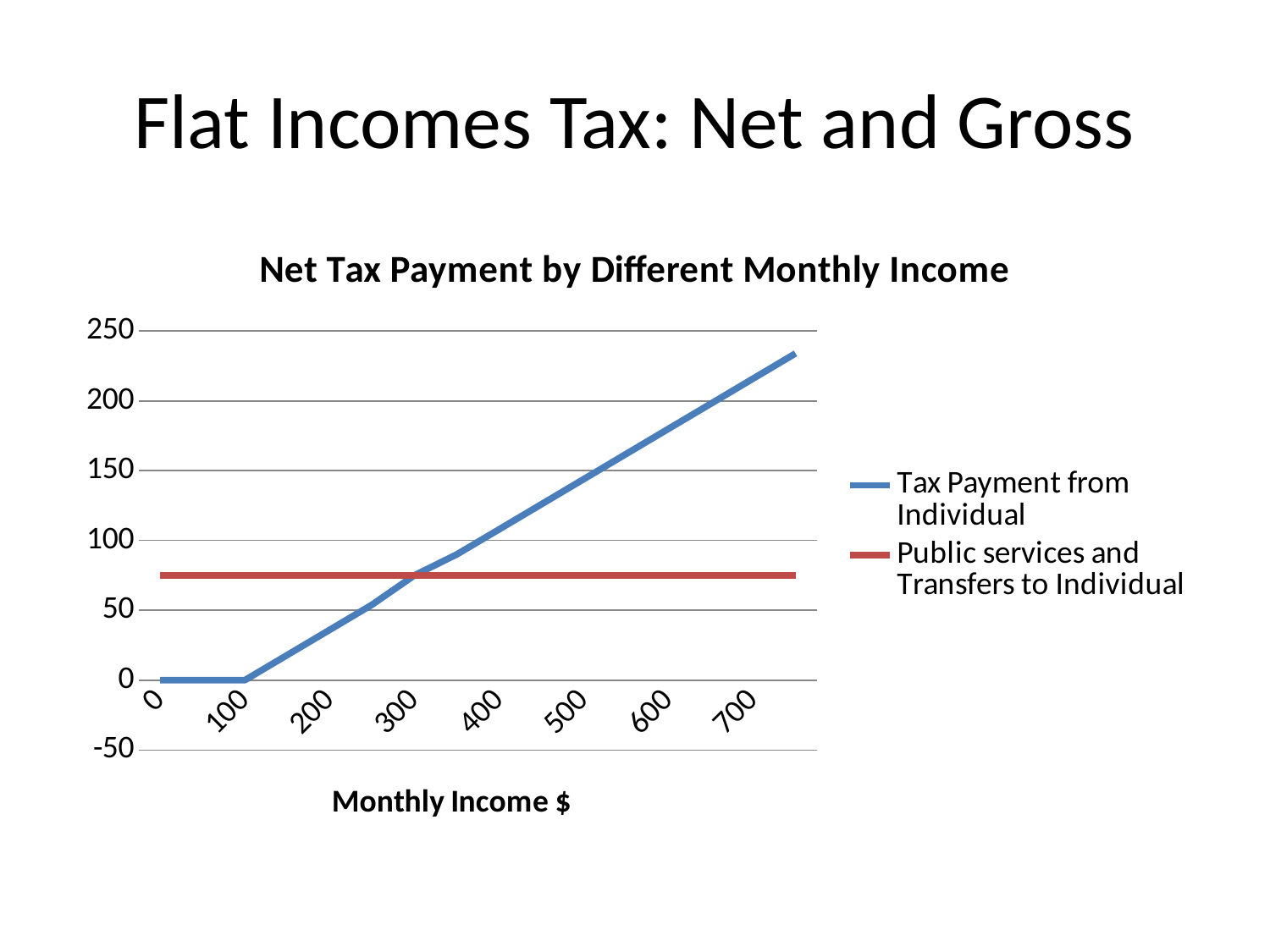
At a monthly income of 200, which series has the larger value: Tax Payment from Individual or Public services and Transfers to Individual? Public services and Transfers to Individual Is the value of Public services and Transfers to Individual greater or less than 100? less What is the value of Tax Payment from Individual at a monthly income of 100? 0 How many series does the legend list? 2 What is the title of the chart? Net Tax Payment by Different Monthly Income Does the Tax Payment from Individual line rise or fall as monthly income increases from 100 to 700? rise What is the value of Tax Payment from Individual at a monthly income of 0? 0 What kind of chart is shown on the slide? line chart Is the value of Tax Payment from Individual at a monthly income of 200 greater or less than 50? less At a monthly income of 700, which series has the larger value: Tax Payment from Individual or Public services and Transfers to Individual? Tax Payment from Individual How many monthly income values are labelled on the x axis? 8 Is the value of Tax Payment from Individual at a monthly income of 700 greater or less than 200? greater